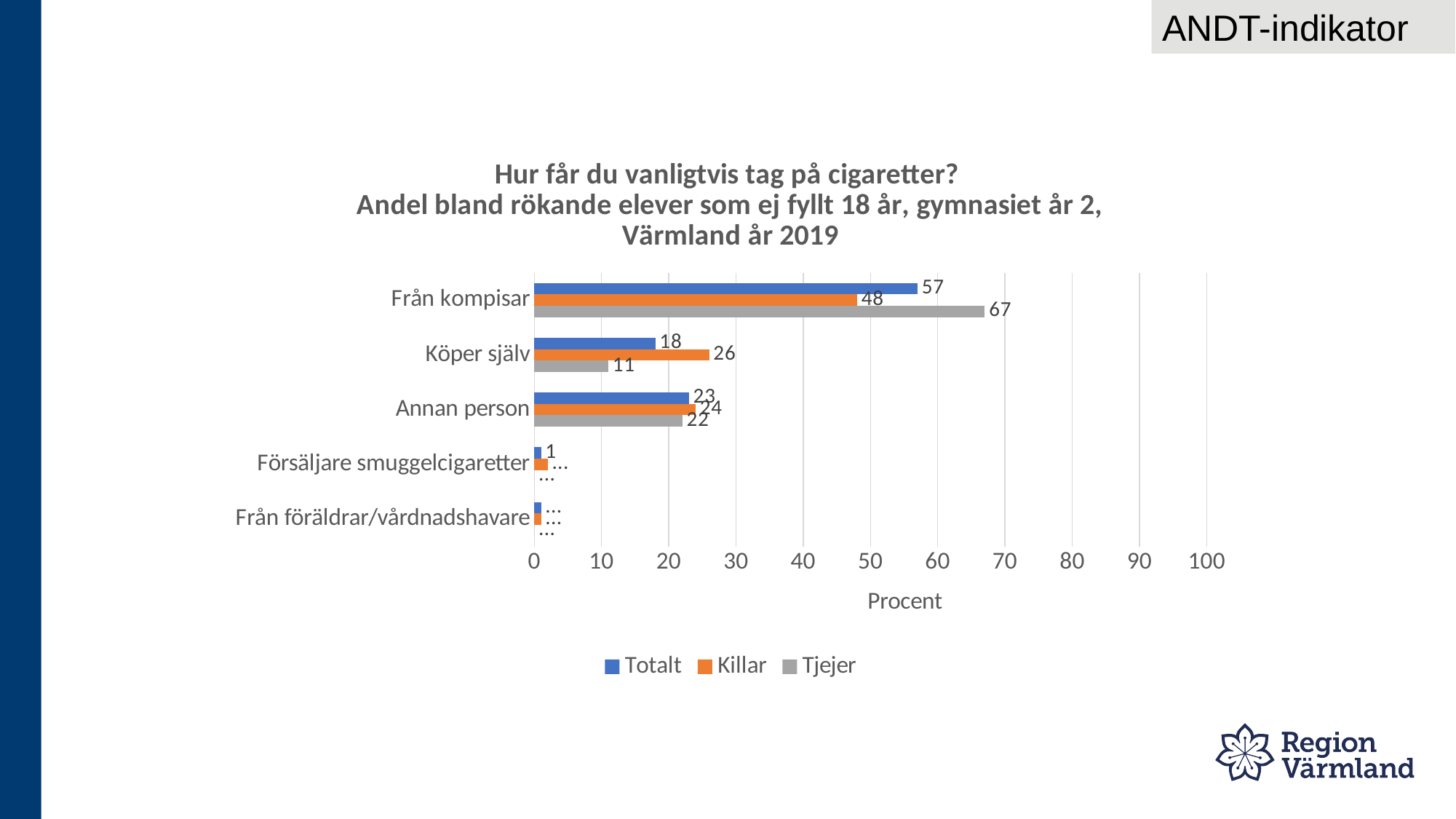
What is the Killar value for Köper själv? 26 What is the Tjejer value for Från kompisar? 67 What is the Totalt value for Från kompisar? 57 What kind of chart is shown on the slide? Bar chart What is the Totalt value for Annan person? 23 Which category has the lowest Tjejer value among Från kompisar, Köper själv and Annan person? Köper själv How many categories are shown on the y axis? 5 Is the Totalt value for Från kompisar greater or less than 50? greater How many series does the legend list? 3 What is the difference between the Tjejer and Killar values for Från kompisar? 19 Which category has the highest Totalt value? Från kompisar Which is larger for Köper själv, the Killar value or the Tjejer value? Killar